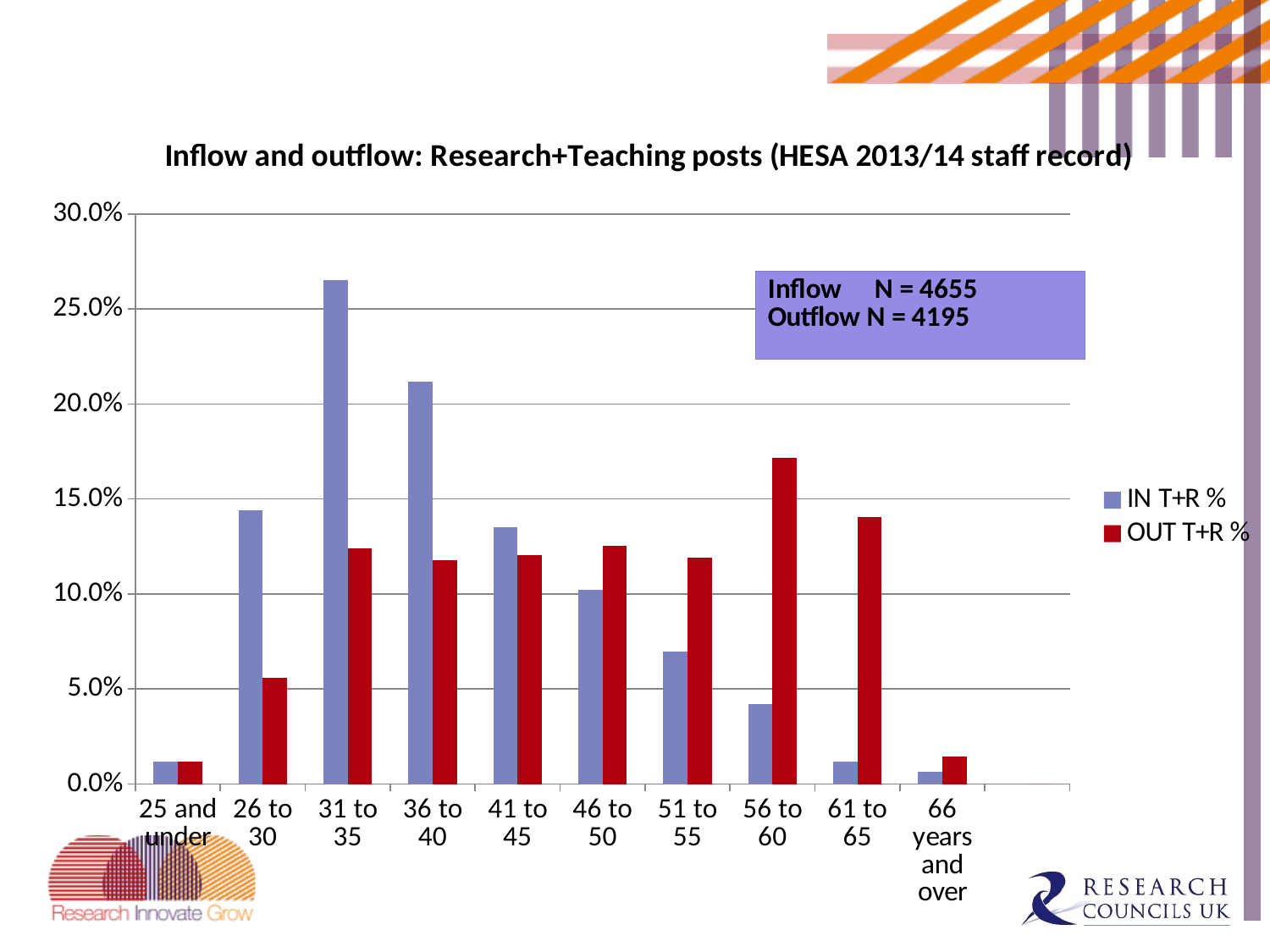
Is the IN T+R % value for 31 to 35 greater or less than 25.0%? greater For the 26 to 30 age group, which is larger: IN T+R % or OUT T+R %? IN T+R % Is the IN T+R % value for 56 to 60 greater or less than 5.0%? less What kind of chart is shown on the slide? bar chart What is the N value given for Inflow in the text box on the chart? 4655 Which age category has the highest IN T+R % value? 31 to 35 Is the OUT T+R % value for 56 to 60 greater or less than 15.0%? greater How many age categories are shown on the x axis? 10 How many series does the legend list? 2 Which age category has the lowest IN T+R % value? 66 years and over Which age category has the highest OUT T+R % value? 56 to 60 For the 61 to 65 age group, which is larger: IN T+R % or OUT T+R %? OUT T+R %